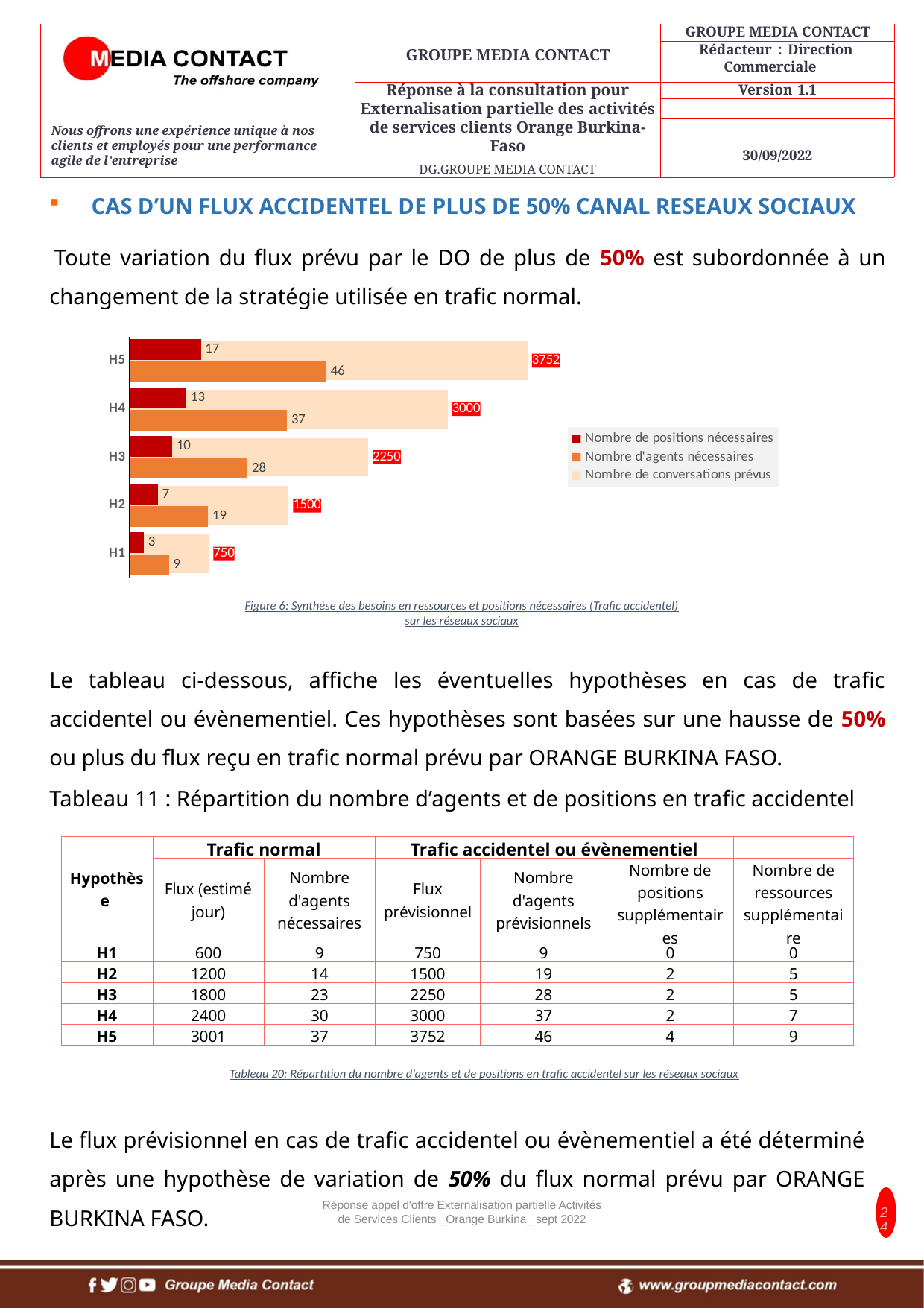
What is the value of 'Nombre de positions nécessaires' for H2? 7 What is the difference in 'Nombre d'agents nécessaires' between H5 and H4? 9 Which category has the highest 'Nombre de conversations prévus'? H5 How many series does the chart legend list? 3 Which category has the lowest 'Nombre d'agents nécessaires'? H1 Which series is shown in dark red on the chart? Nombre de positions nécessaires What is the value of 'Nombre de conversations prévus' for H5? 3752 What kind of chart is shown on the slide? bar chart How many hypothesis categories are plotted on the chart? 5 What is the value of 'Nombre d'agents nécessaires' for H3? 28 Do the 'Nombre de conversations prévus' values rise or fall from H1 to H5? rise Which is larger: 'Nombre de positions nécessaires' for H4 or for H3? H4